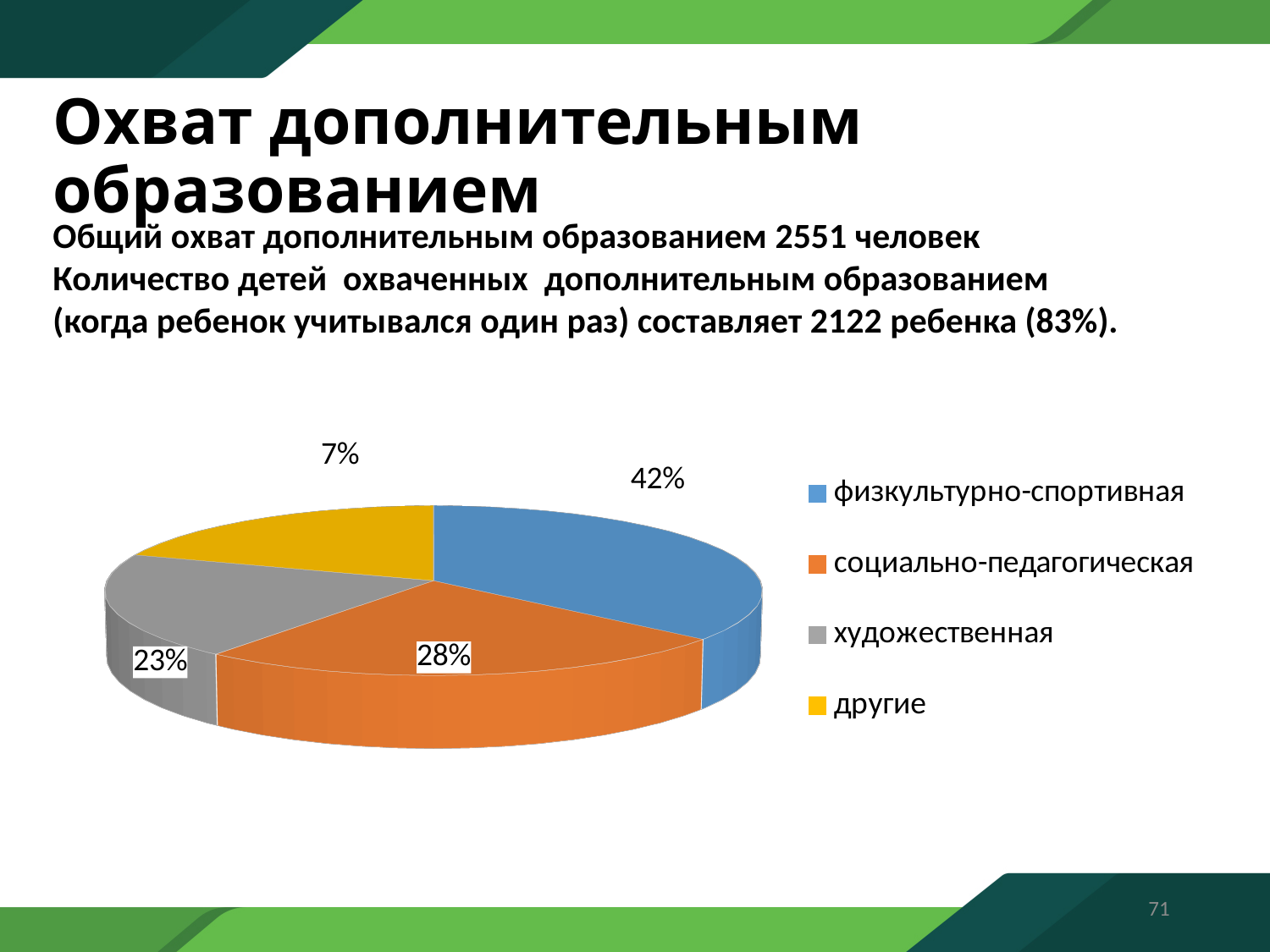
Which category has the largest slice of the pie? физкультурно-спортивная What share of the pie does художественная have? 23% What kind of chart is shown on the slide? pie chart What is the difference in percentage points between художественная and другие? 16 What share of the pie does социально-педагогическая have? 28% What colour is the slice for другие? yellow Which category has the smallest slice of the pie? другие Which is larger, социально-педагогическая or художественная? социально-педагогическая How many categories does the pie chart show? 4 What share of the pie does физкультурно-спортивная have? 42% What is the difference in percentage points between физкультурно-спортивная and социально-педагогическая? 14